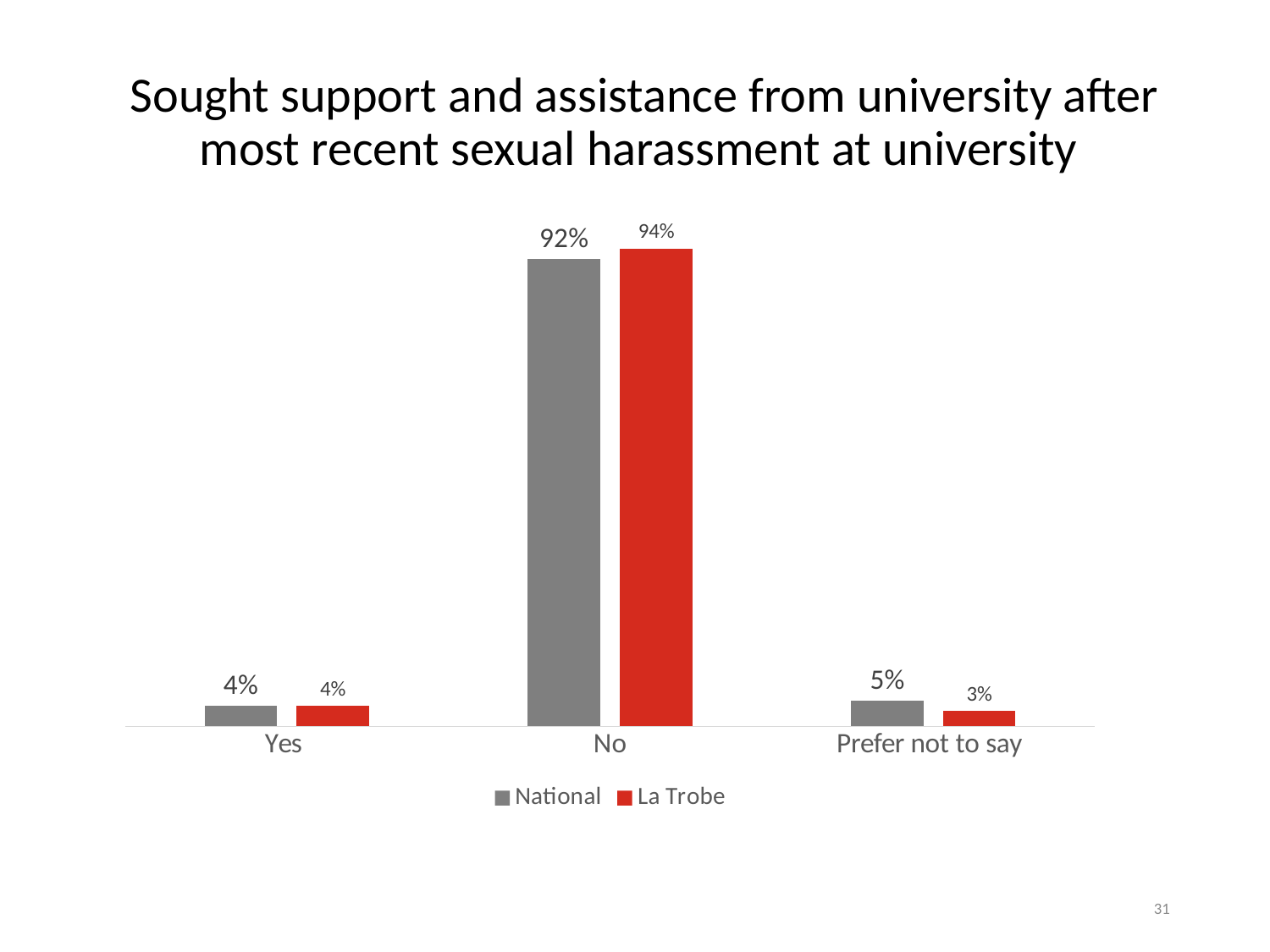
How many categories are shown on the x axis? 3 What kind of chart is shown on the slide? Bar chart What is the La Trobe value for "Prefer not to say"? 3% How many series does the legend list? 2 Which colour represents the La Trobe series? Red Which category has the lowest La Trobe value? Prefer not to say Which category has the highest La Trobe value? No What is the National value for "No"? 92% For "Prefer not to say", which series has the larger value, National or La Trobe? National What is the National value for "Yes"? 4% What is the La Trobe value for "No"? 94% What is the difference between the La Trobe and National values for "No"? 2%